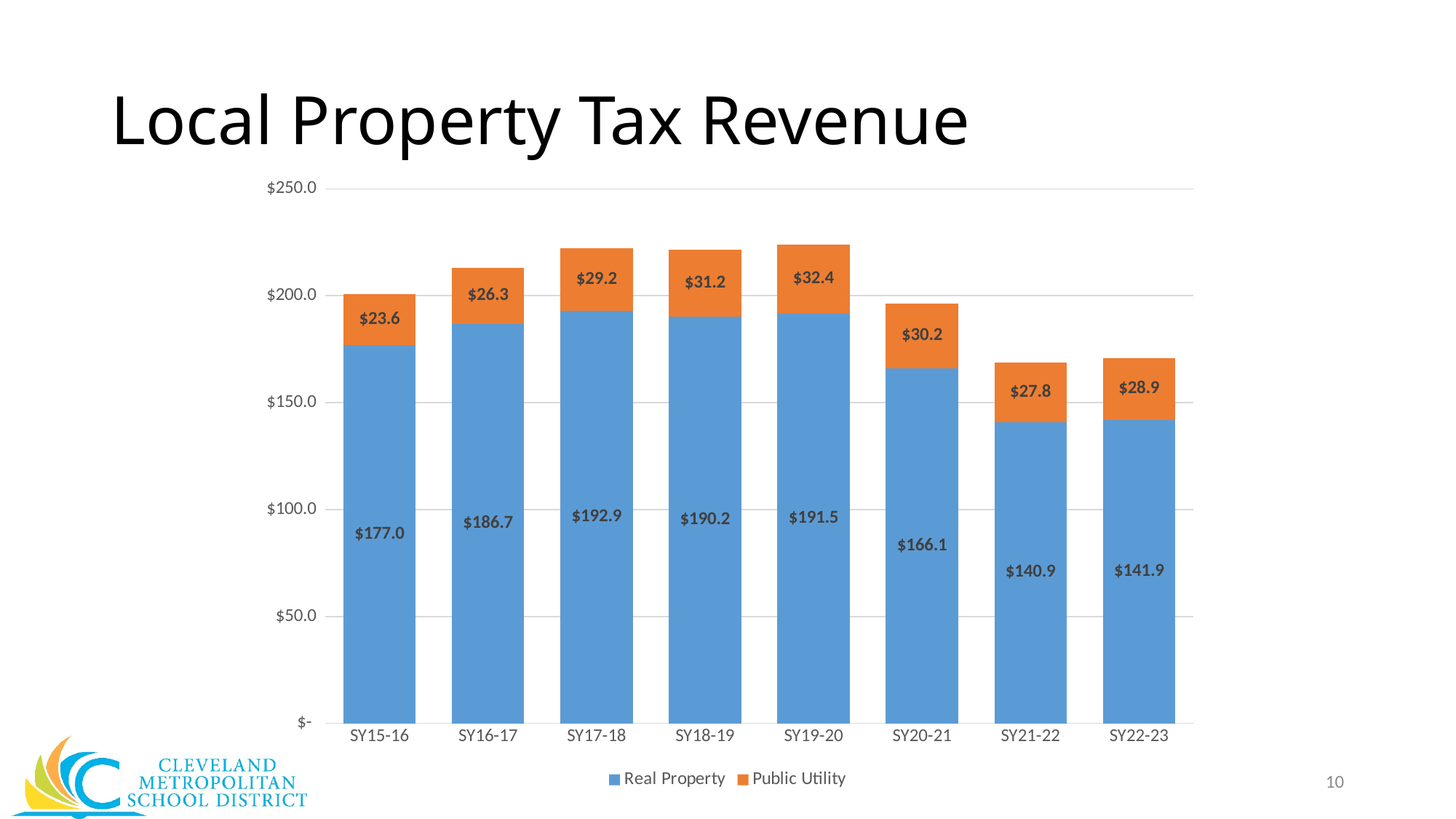
What type of chart is shown on the slide? Stacked bar chart What is the Real Property value for SY17-18? $192.9 How many school years are shown on the x axis? 8 Which school year has the lowest Public Utility value? SY15-16 What is the Public Utility value for SY19-20? $32.4 What is the total of the stacked bar for SY15-16? $200.6 What is the Real Property value for SY21-22? $140.9 How many series does the legend list? 2 Which school year has the highest Real Property value? SY17-18 Which is larger, the Public Utility value for SY18-19 or for SY20-21? SY18-19 What is the difference between the Real Property values for SY19-20 and SY20-21? $25.4 What is the total of the stacked bar for SY22-23? $170.8